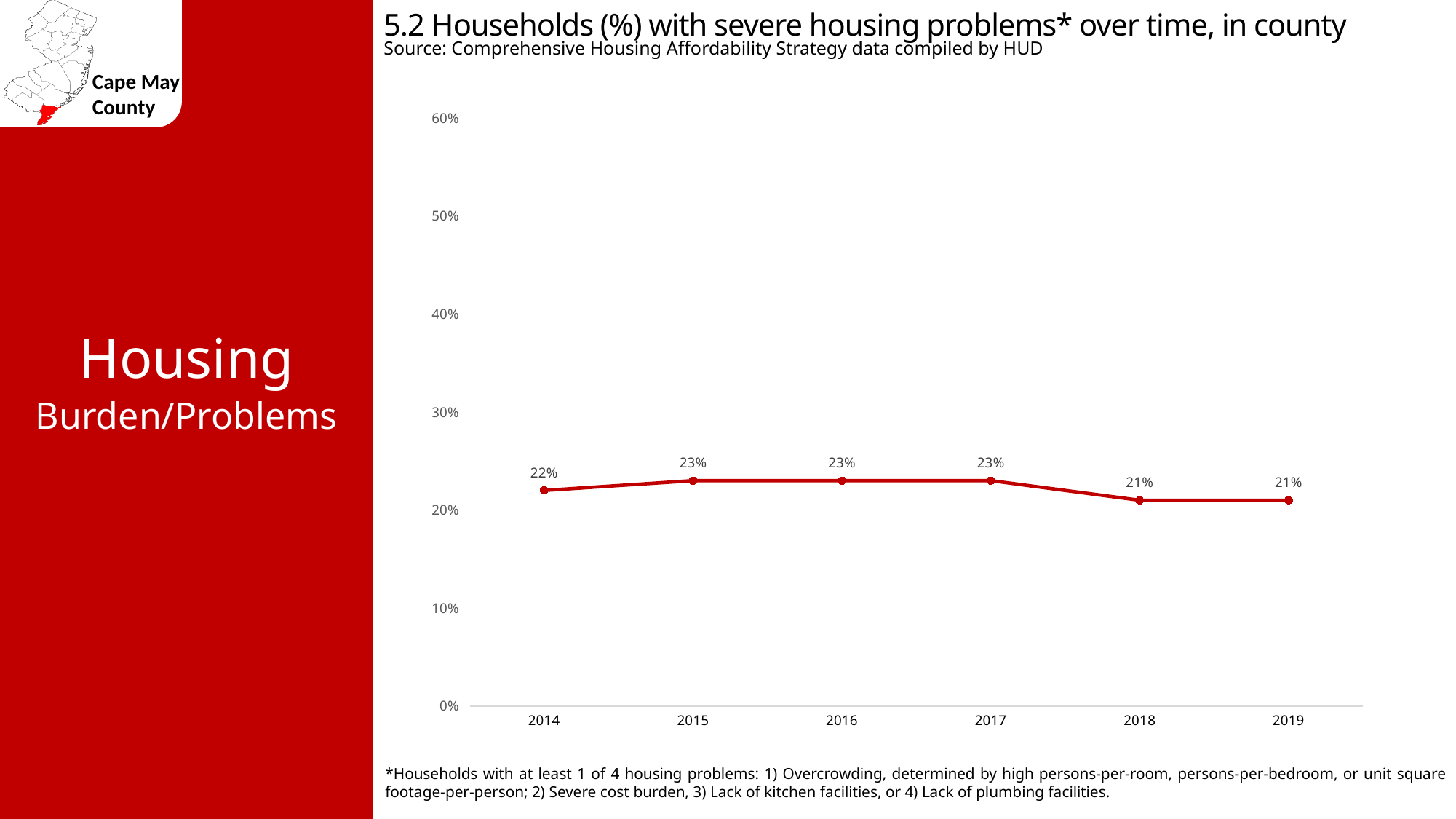
What percentage of households had severe housing problems in 2019? 21% Which year has the larger value, 2014 or 2016? 2016 What is the value shown for 2017? 23% What kind of chart is shown on the slide? line chart What percentage of households had severe housing problems in 2014? 22% Is the value for 2017 greater or less than 30%? less What is the highest value plotted on the chart? 23% How many years are plotted on the chart? 6 What is the difference between the value for 2015 and the value for 2018? 2 percentage points What is the value shown for 2018? 21% Does the value rise or fall from 2017 to 2018? fall What is the lowest value plotted on the chart? 21%